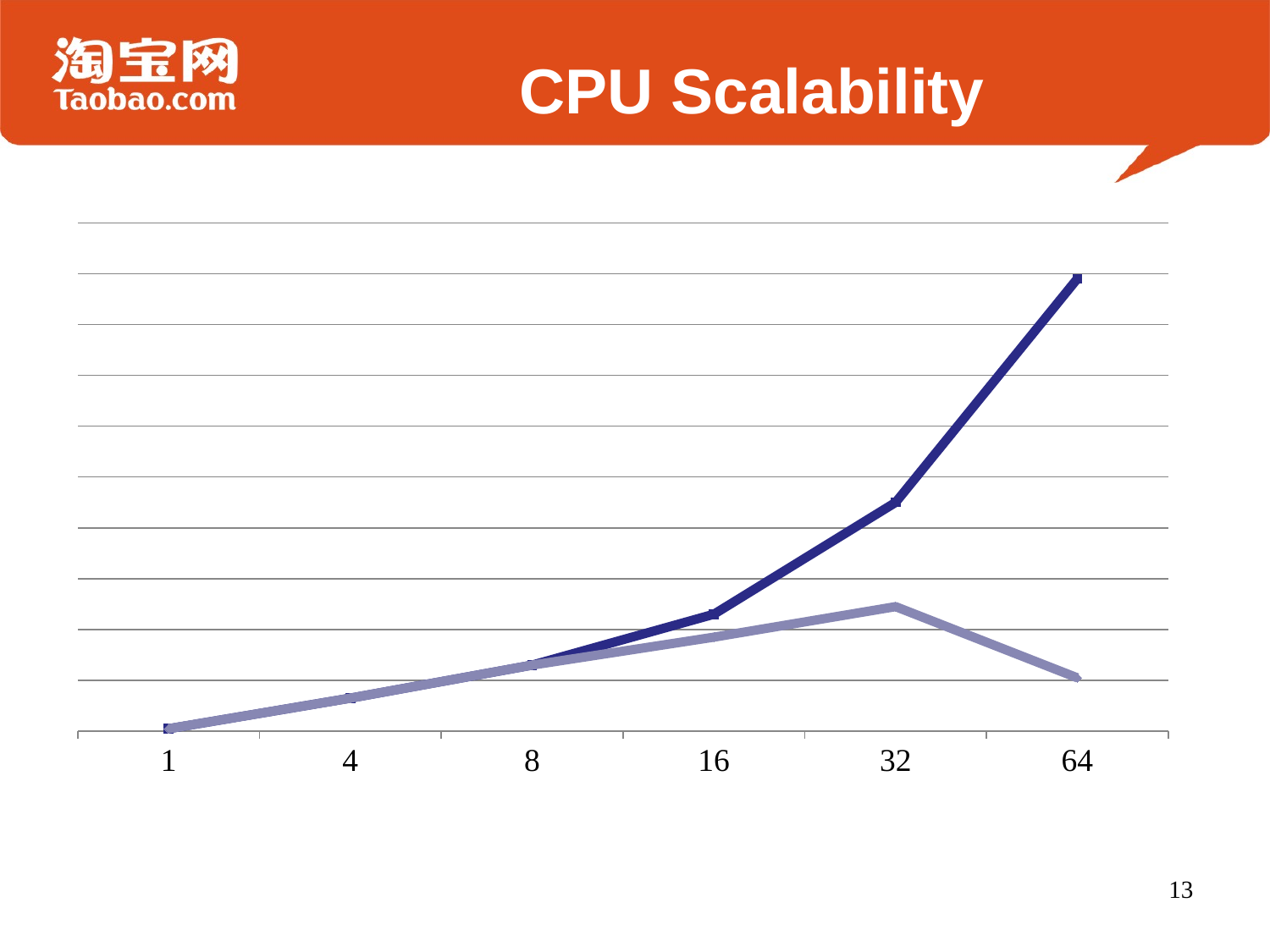
Does the light purple line rise or fall between 32 and 64? fall At x = 64, which line has the larger value, the dark blue line or the light purple line? dark blue line Does the dark blue line rise or fall from 1 to 64 along the x axis? rise At which x-axis category does the dark blue line have its lowest value? 1 What is the last category label on the x axis? 64 At x = 32, which line has the larger value, the dark blue line or the light purple line? dark blue line At which x-axis category does the light purple line reach its highest value? 32 What is the first category label on the x axis? 1 At which x-axis category does the dark blue line reach its highest value? 64 How many lines are plotted on the chart? 2 How many categories are labelled on the x axis? 6 What kind of chart is shown on the slide? line chart